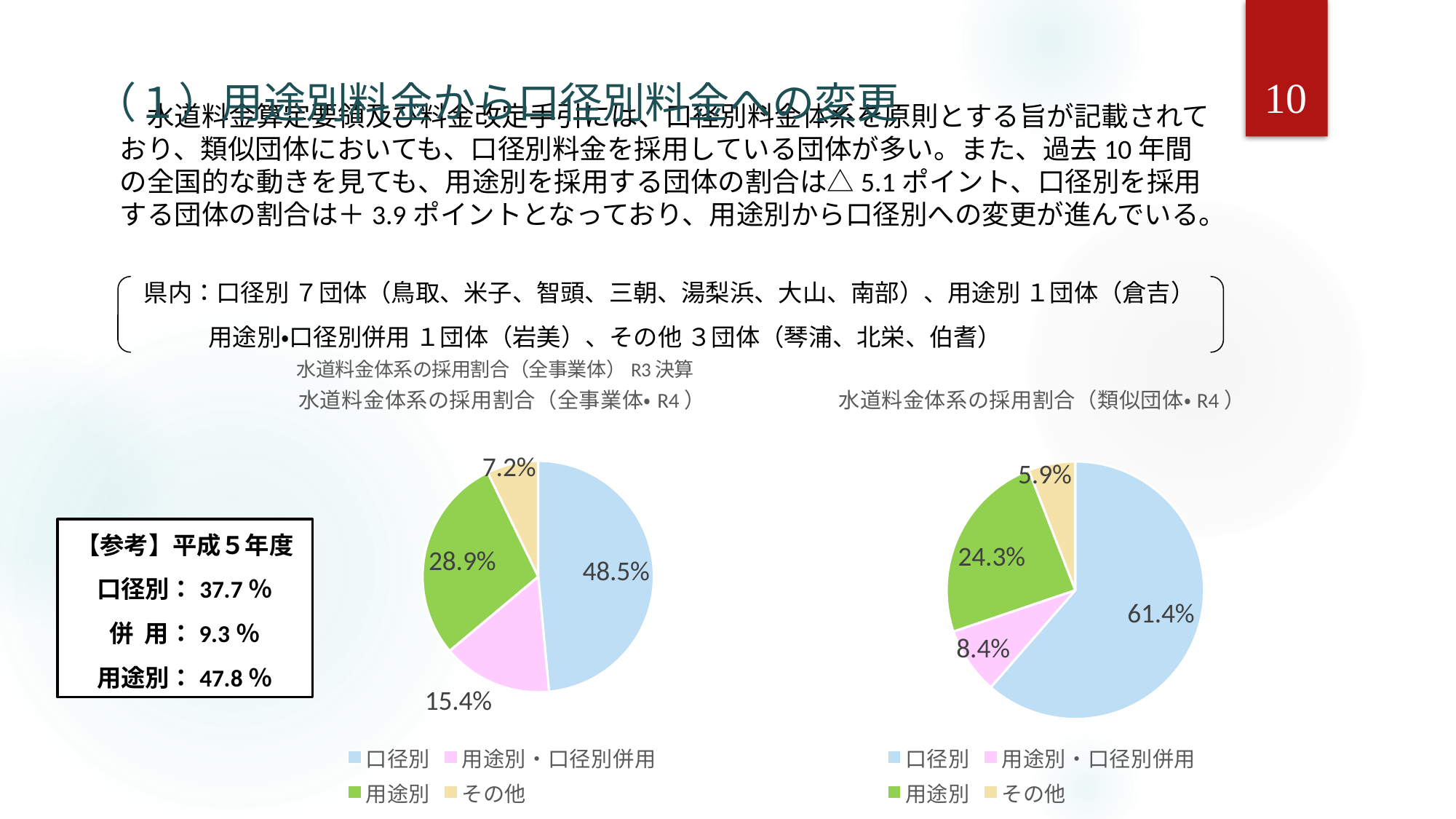
In the right pie chart (類似団体・R4), what is the share for 用途別? 24.3% In the right pie chart (類似団体・R4), what is the difference between the shares of 用途別 and 用途別・口径別併用? 15.9 percentage points In the left pie chart (全事業体), what is the difference between the shares of 口径別 and 用途別? 19.6 percentage points In the right pie chart (類似団体・R4), what colour is the 用途別 slice? green How many categories does the left pie chart (全事業体) have? 4 In the left pie chart (全事業体), what is the share for 口径別? 48.5% In the left pie chart (全事業体), what is the share for 用途別・口径別併用? 15.4% In the right pie chart (類似団体・R4), which category has the largest share? 口径別 In the right pie chart (類似団体・R4), what is the share for その他? 5.9% Which chart shows a larger share for 口径別, the left (全事業体) or the right (類似団体・R4)? the right (類似団体・R4) In the left pie chart (全事業体), which category has the smallest share? その他 What type of chart is used on this slide? pie chart